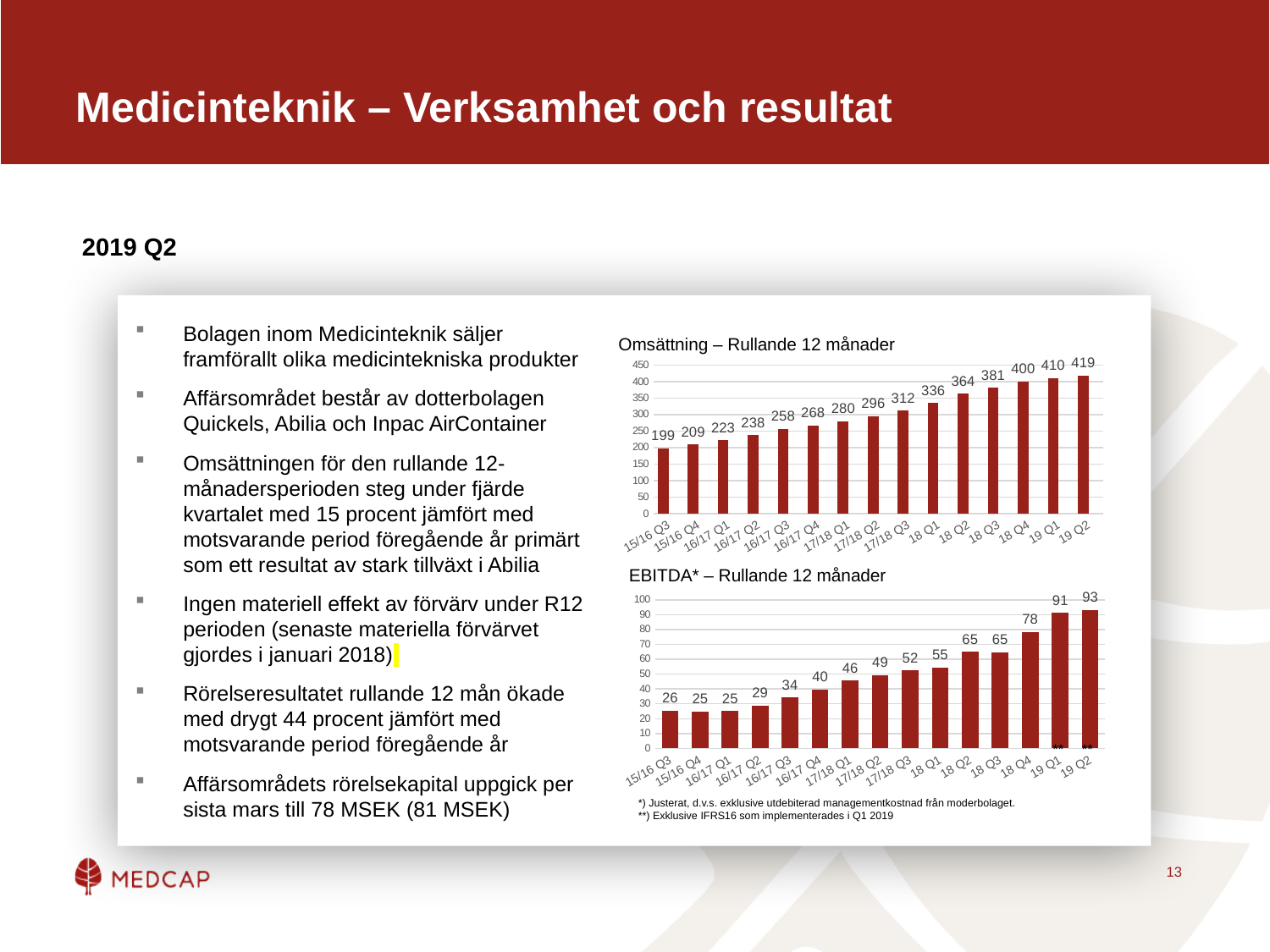
In the 'EBITDA* – Rullande 12 månader' chart, what is the value for 18 Q4? 78 In the 'EBITDA* – Rullande 12 månader' chart, which period has the highest value? 19 Q2 In the 'EBITDA* – Rullande 12 månader' chart, which is larger, the value for 17/18 Q2 or the value for 18 Q1? 18 Q1 In the 'EBITDA* – Rullande 12 månader' chart, what is the difference between the values for 19 Q1 and 18 Q4? 13 In the 'Omsättning – Rullande 12 månader' chart, what is the value for 17/18 Q1? 280 In the 'Omsättning – Rullande 12 månader' chart, what is the value for 19 Q2? 419 In the 'Omsättning – Rullande 12 månader' chart, how many periods are plotted? 15 What type of chart is the 'EBITDA* – Rullande 12 månader' chart? bar chart In the 'Omsättning – Rullande 12 månader' chart, which period has the lowest value? 15/16 Q3 In the 'Omsättning – Rullande 12 månader' chart, do the values rise or fall from left to right? rise In the 'EBITDA* – Rullande 12 månader' chart, what is the value for 16/17 Q3? 34 In the 'Omsättning – Rullande 12 månader' chart, what is the difference between the values for 19 Q2 and 15/16 Q3? 220